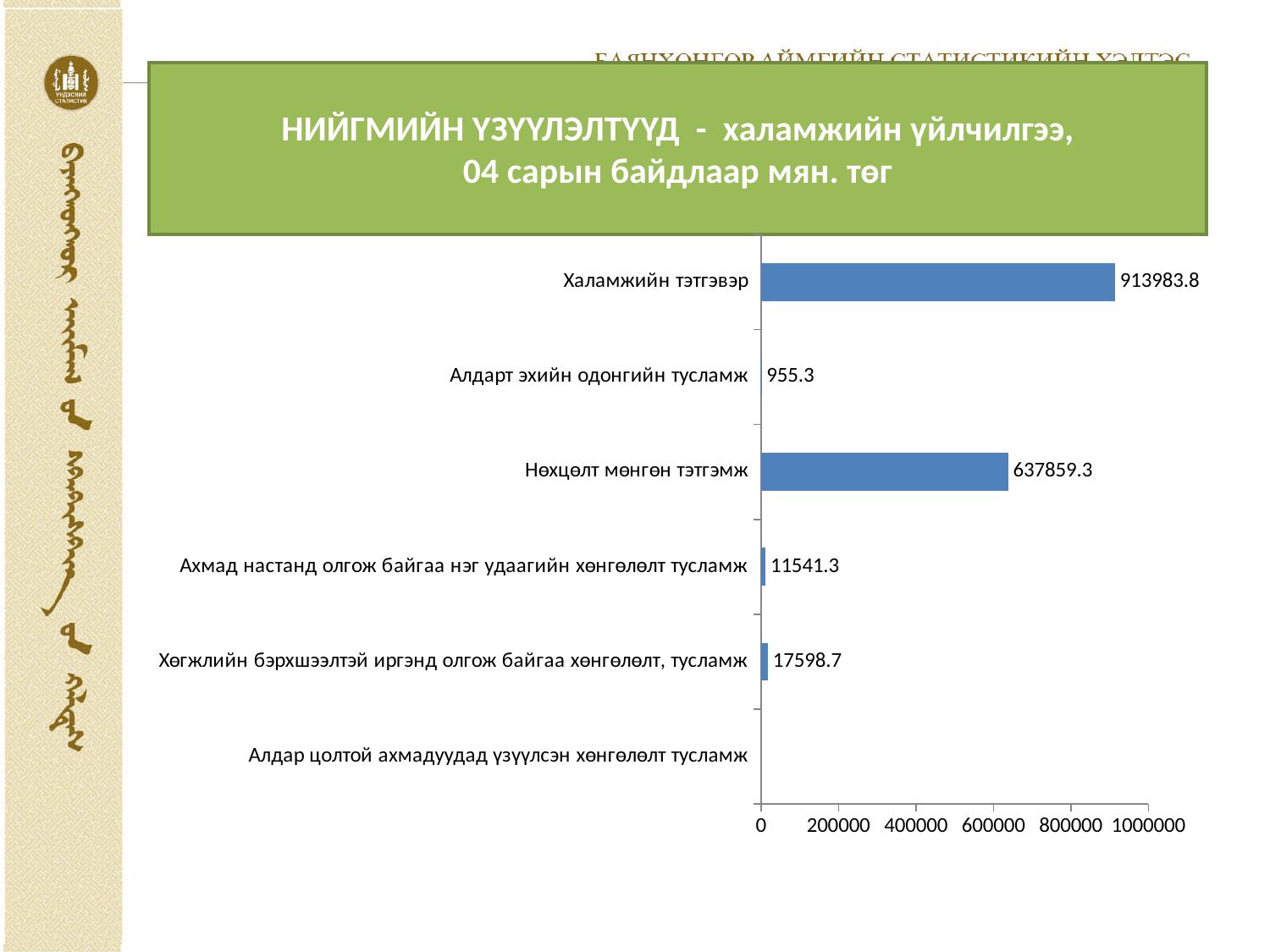
Which category has the highest value? Халамжийн тэтгэвэр What is the value for Алдарт эхийн одонгийн тусламж? 955.3 What is the difference between the values for Хөгжлийн бэрхшээлтэй иргэнд олгож байгаа хөнгөлөлт, тусламж and Ахмад настанд олгож байгаа нэг удаагийн хөнгөлөлт тусламж? 6057.4 What is the value for Ахмад настанд олгож байгаа нэг удаагийн хөнгөлөлт тусламж? 11541.3 What kind of chart is shown on the slide? bar chart What is the difference between the values for Халамжийн тэтгэвэр and Нөхцөлт мөнгөн тэтгэмж? 276124.5 Is the value for Нөхцөлт мөнгөн тэтгэмж greater or less than 800000? less What is the value for Халамжийн тэтгэвэр? 913983.8 How many categories are shown on the chart? 6 What is the value for Нөхцөлт мөнгөн тэтгэмж? 637859.3 What is the value for Хөгжлийн бэрхшээлтэй иргэнд олгож байгаа хөнгөлөлт, тусламж? 17598.7 Which is larger, the value for Нөхцөлт мөнгөн тэтгэмж or the value for Алдарт эхийн одонгийн тусламж? Нөхцөлт мөнгөн тэтгэмж